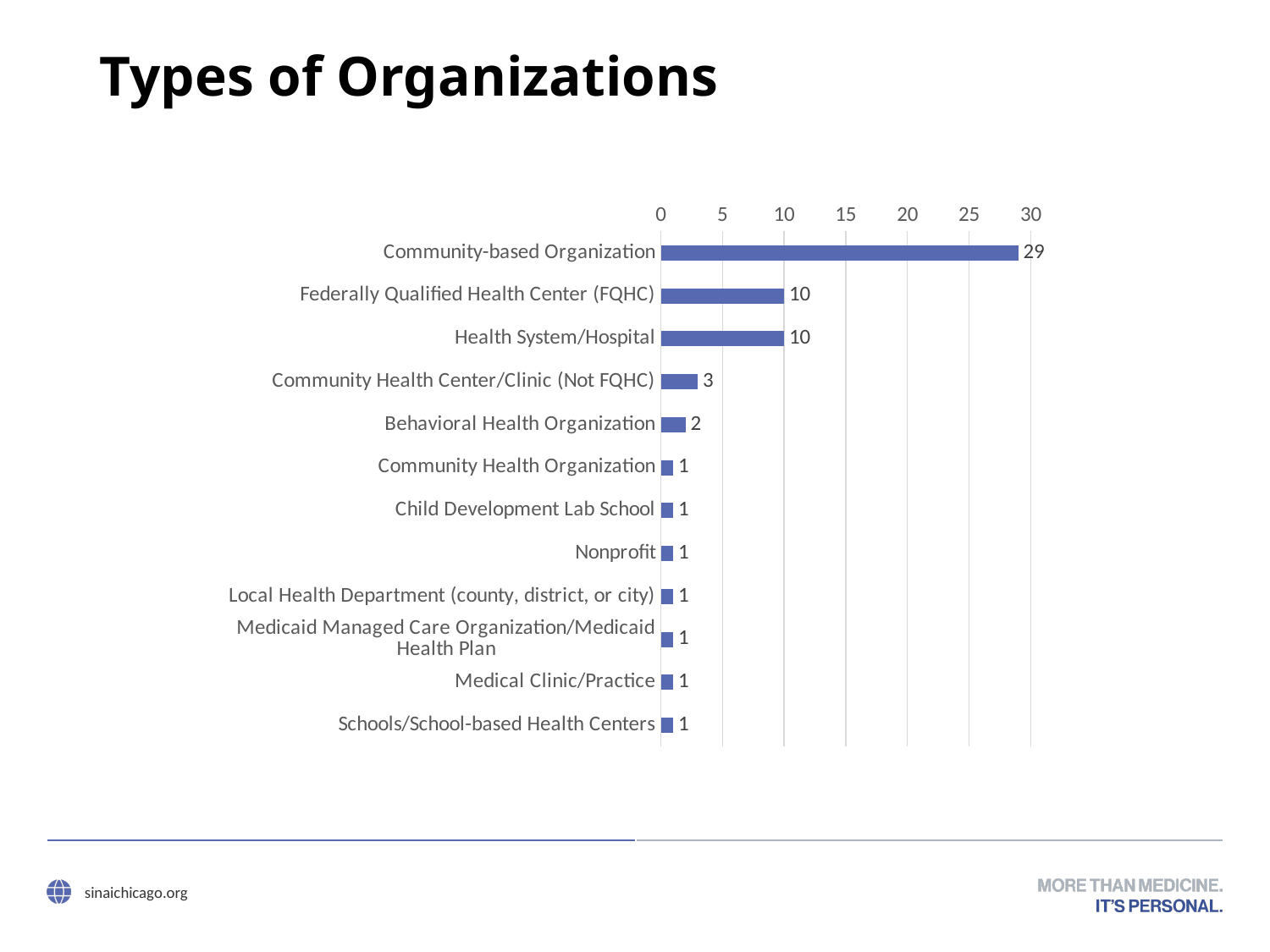
What is the value for Behavioral Health Organization? 2 What is the title of the slide? Types of Organizations Which category has the highest value? Community-based Organization What is the value for Health System/Hospital? 10 Is the value for Community-based Organization greater or less than 25? greater What is the difference between the values for Community-based Organization and Federally Qualified Health Center (FQHC)? 19 How many categories have a value of 1? 7 What is the value for Community-based Organization? 29 How many categories are shown in the chart? 12 Which is larger, the value for Community Health Center/Clinic (Not FQHC) or the value for Behavioral Health Organization? Community Health Center/Clinic (Not FQHC) What kind of chart is shown on the slide? bar chart What is the value for Community Health Center/Clinic (Not FQHC)? 3